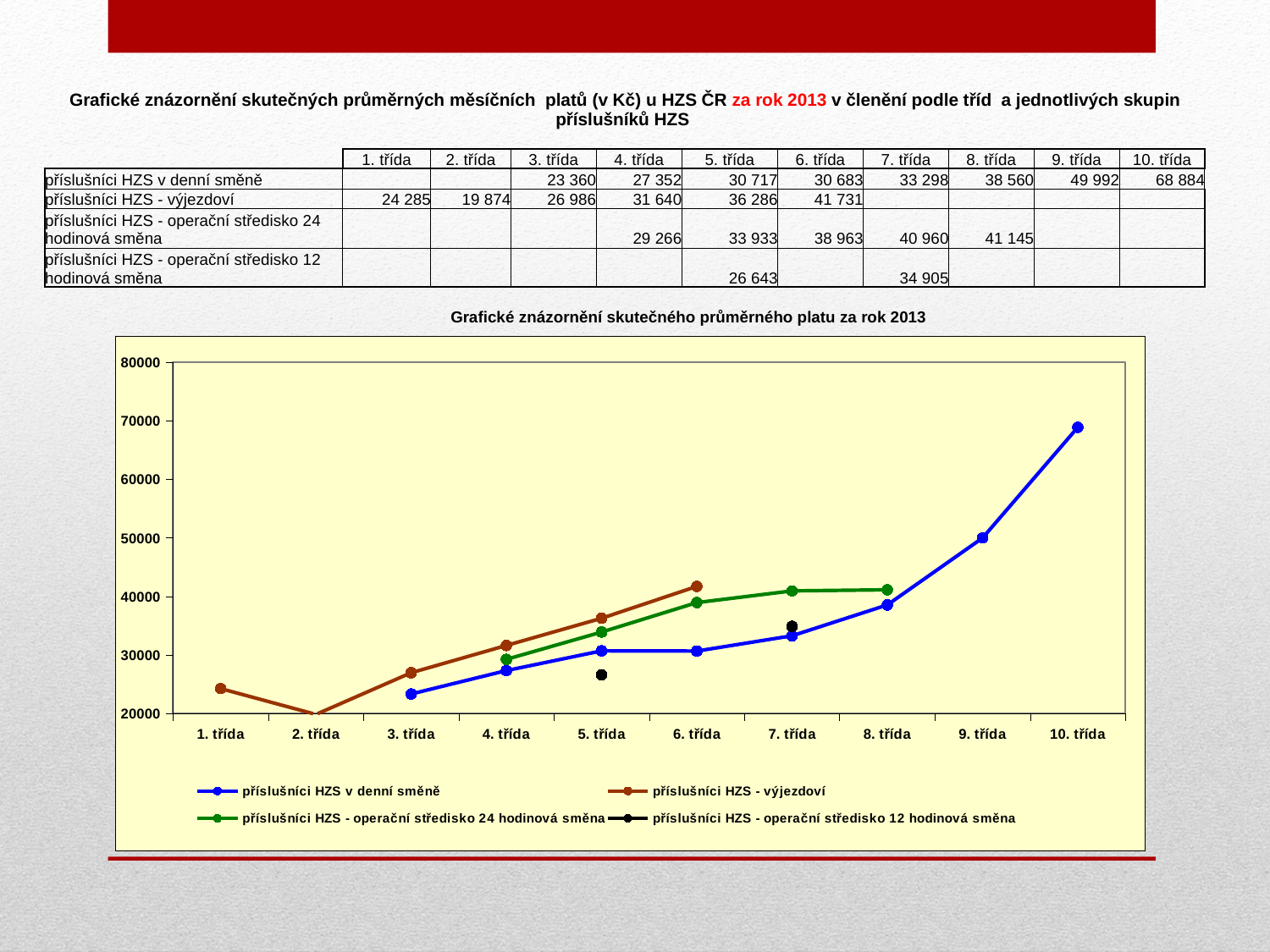
What is the value for příslušníci HZS v denní směně in 10. třída? 68 884 What is the value for příslušníci HZS - operační středisko 12 hodinová směna in 7. třída? 34 905 In 5. třída, which is larger: příslušníci HZS - výjezdoví or příslušníci HZS - operační středisko 24 hodinová směna? příslušníci HZS - výjezdoví In which třída is the value for příslušníci HZS - výjezdoví lowest? 2. třída How many series does the chart legend list? 4 In which třída is the value for příslušníci HZS v denní směně highest? 10. třída Is the value for příslušníci HZS v denní směně in 9. třída greater or less than 40000? greater What is the difference between příslušníci HZS - výjezdoví and příslušníci HZS v denní směně in 6. třída? 11 048 What kind of chart is shown on the slide? line chart Does the line for příslušníci HZS v denní směně rise or fall from 3. třída to 10. třída? rises How many categories (třídy) are shown on the x axis of the chart? 10 What colour is the line for příslušníci HZS - výjezdoví? brown